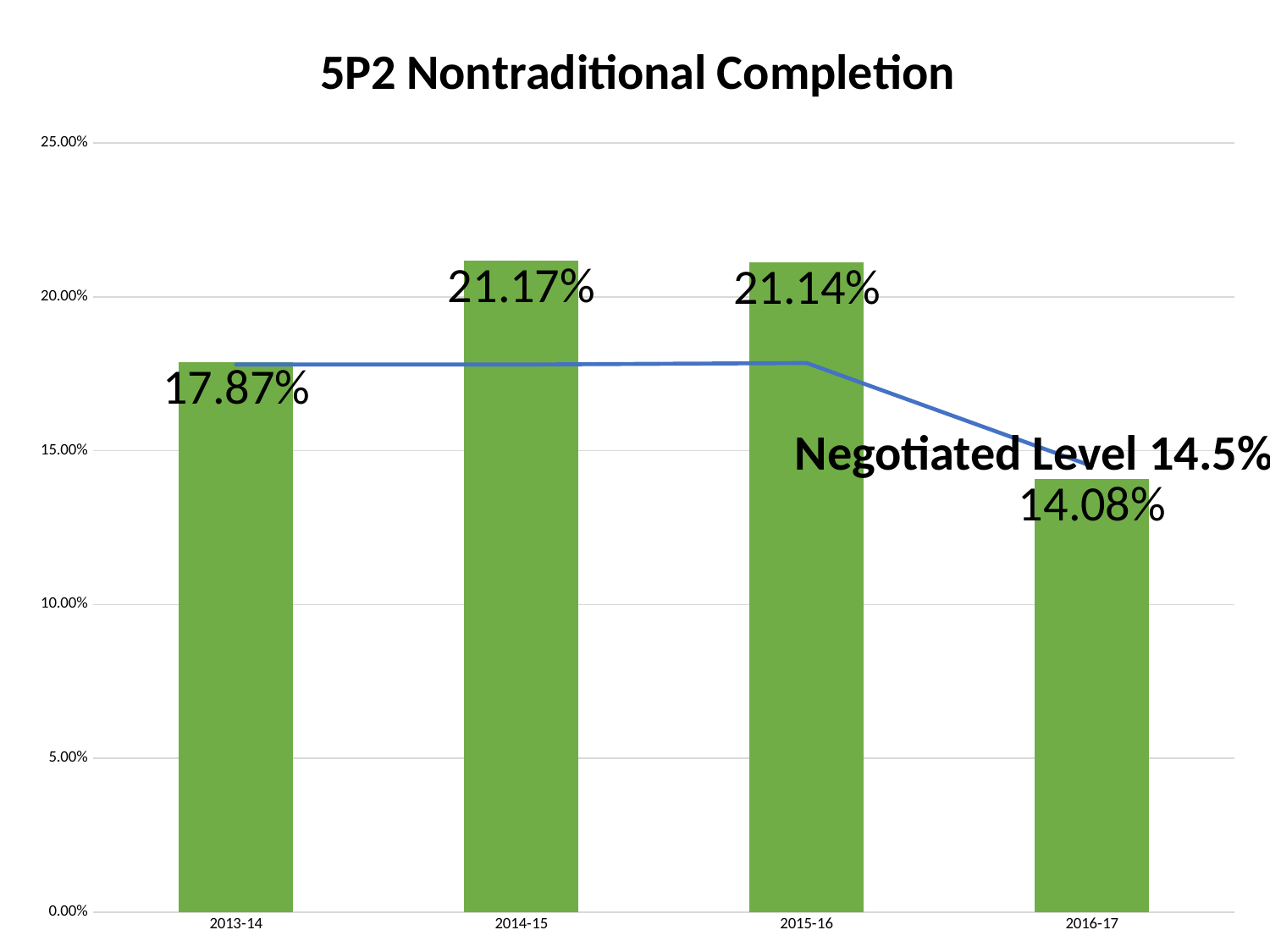
What is the difference between the values for 2013-14 and 2016-17? 3.79% What is the value for 2014-15? 21.17% What is the difference between the values for 2014-15 and 2016-17? 7.09% What kind of chart is this? combination bar and line chart What is the value for 2016-17? 14.08% Is the value for 2016-17 greater or less than 15.00%? less Which year has the highest value? 2014-15 What is the value for 2013-14? 17.87% How many years are shown on the x axis? 4 Which is larger, the value for 2013-14 or the value for 2015-16? 2015-16 What is the title of the chart? 5P2 Nontraditional Completion Which year has the lowest value? 2016-17